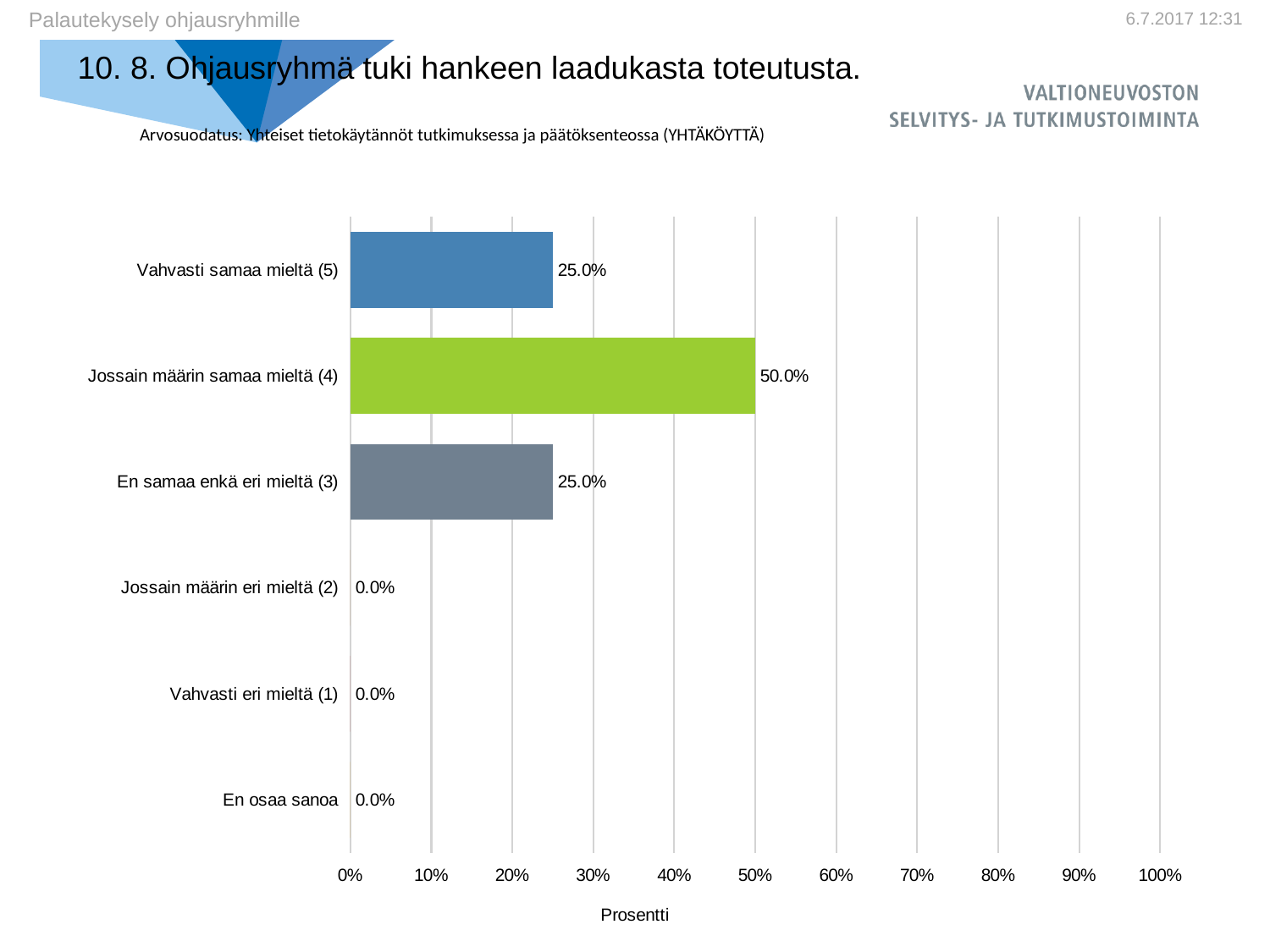
Which is larger, the value for "Jossain määrin samaa mieltä (4)" or the value for "En samaa enkä eri mieltä (3)"? Jossain määrin samaa mieltä (4) How many categories are shown on the chart? 6 What is the value for "Vahvasti eri mieltä (1)"? 0.0% Which category has the highest value? Jossain määrin samaa mieltä (4) Is the value for "Jossain määrin samaa mieltä (4)" greater or less than 40%? greater What is the value for "En samaa enkä eri mieltä (3)"? 25.0% How many categories have a value of 0.0%? 3 What is the value for "Jossain määrin samaa mieltä (4)"? 50.0% What is the value for "Vahvasti samaa mieltä (5)"? 25.0% What is the label of the x axis? Prosentti What kind of chart is shown on the slide? bar chart What is the difference between the values for "Jossain määrin samaa mieltä (4)" and "Vahvasti samaa mieltä (5)"? 25.0%